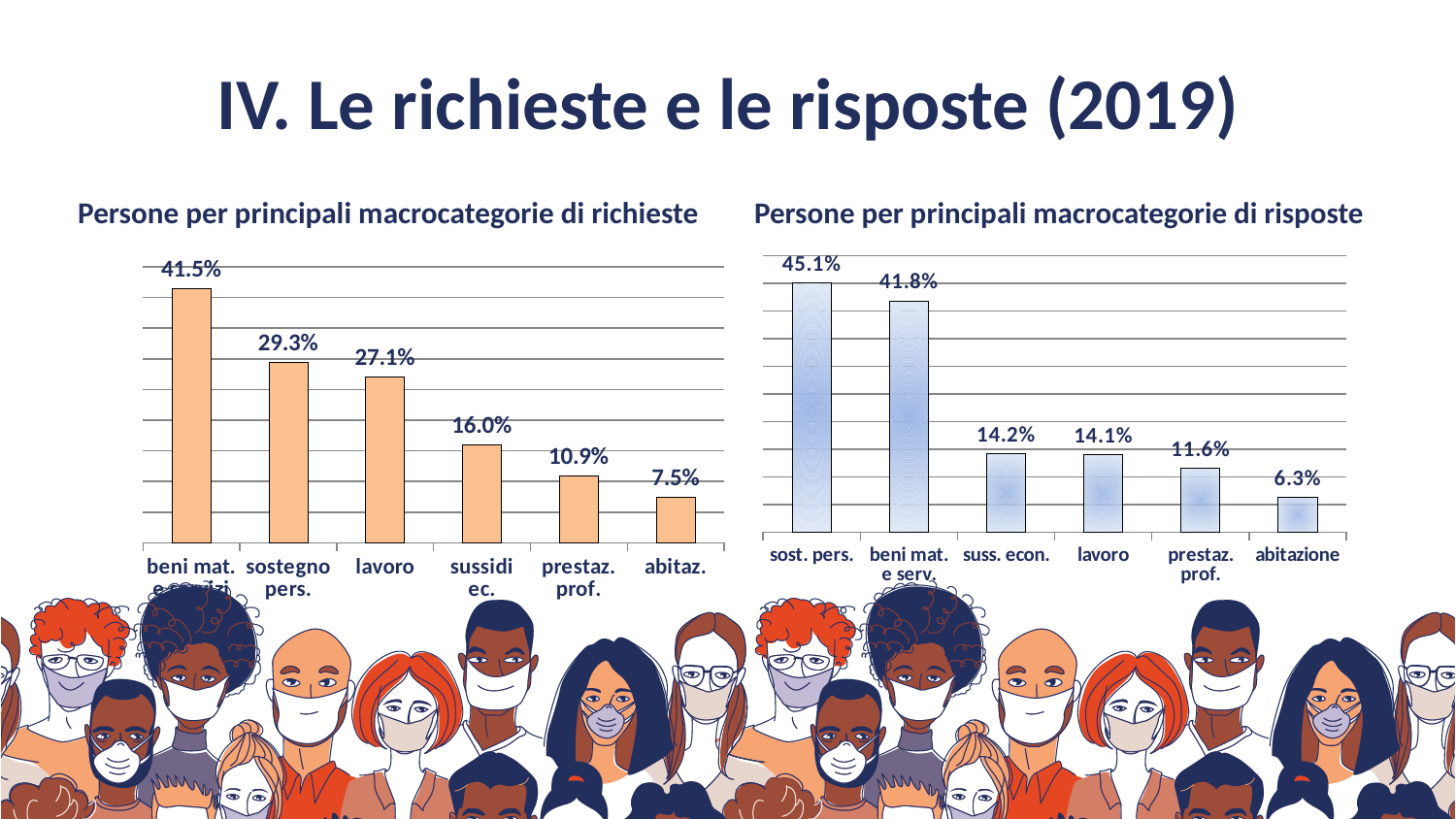
In the chart 'Persone per principali macrocategorie di richieste', what is the difference between sostegno pers. and prestaz. prof.? 18.4% In the chart 'Persone per principali macrocategorie di risposte', which category has the highest value? sost. pers. In the chart 'Persone per principali macrocategorie di risposte', what is the value for sost. pers.? 45.1% In the chart 'Persone per principali macrocategorie di richieste', what is the value for sussidi ec.? 16.0% In the chart 'Persone per principali macrocategorie di richieste', what is the value for lavoro? 27.1% In the chart 'Persone per principali macrocategorie di risposte', do the values rise or fall from left to right? fall In the chart 'Persone per principali macrocategorie di richieste', which category has the lowest value? abitaz. In the chart 'Persone per principali macrocategorie di risposte', what is the difference between sost. pers. and beni mat. e serv.? 3.3% In the chart 'Persone per principali macrocategorie di risposte', which is larger: beni mat. e serv. or prestaz. prof.? beni mat. e serv. In the chart 'Persone per principali macrocategorie di richieste', how many categories are shown? 6 In the chart 'Persone per principali macrocategorie di risposte', what is the value for abitazione? 6.3% What kind of chart is 'Persone per principali macrocategorie di richieste'? bar chart